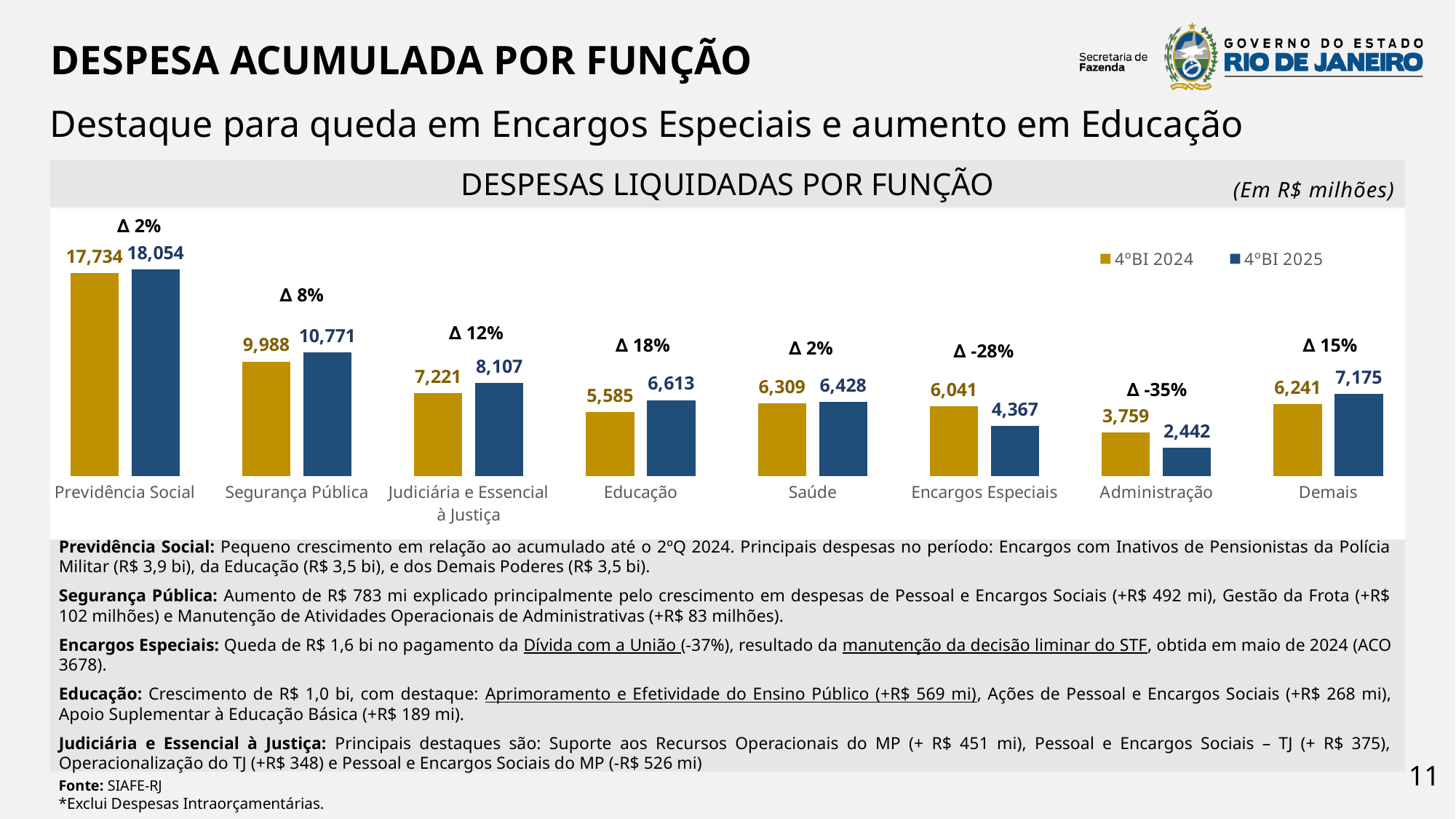
What is the value for Encargos Especiais in the 4ºBI 2024 series? 6,041 Which is larger for Encargos Especiais: the 4ºBI 2024 value or the 4ºBI 2025 value? 4ºBI 2024 What percentage change is shown above the bars for Administração? Δ -35% What is the title of the chart? DESPESAS LIQUIDADAS POR FUNÇÃO How many categories are shown on the x axis of the chart? 8 Which category has the lowest value in the 4ºBI 2024 series? Administração What is the value for Administração in the 4ºBI 2025 series? 2,442 Which category has the highest value in the 4ºBI 2025 series? Previdência Social How many series does the legend list? 2 What is the value for Previdência Social in the 4ºBI 2025 series? 18,054 What is the difference between the 4ºBI 2025 and 4ºBI 2024 values for Educação? 1,028 What kind of chart is shown on the slide? Bar chart